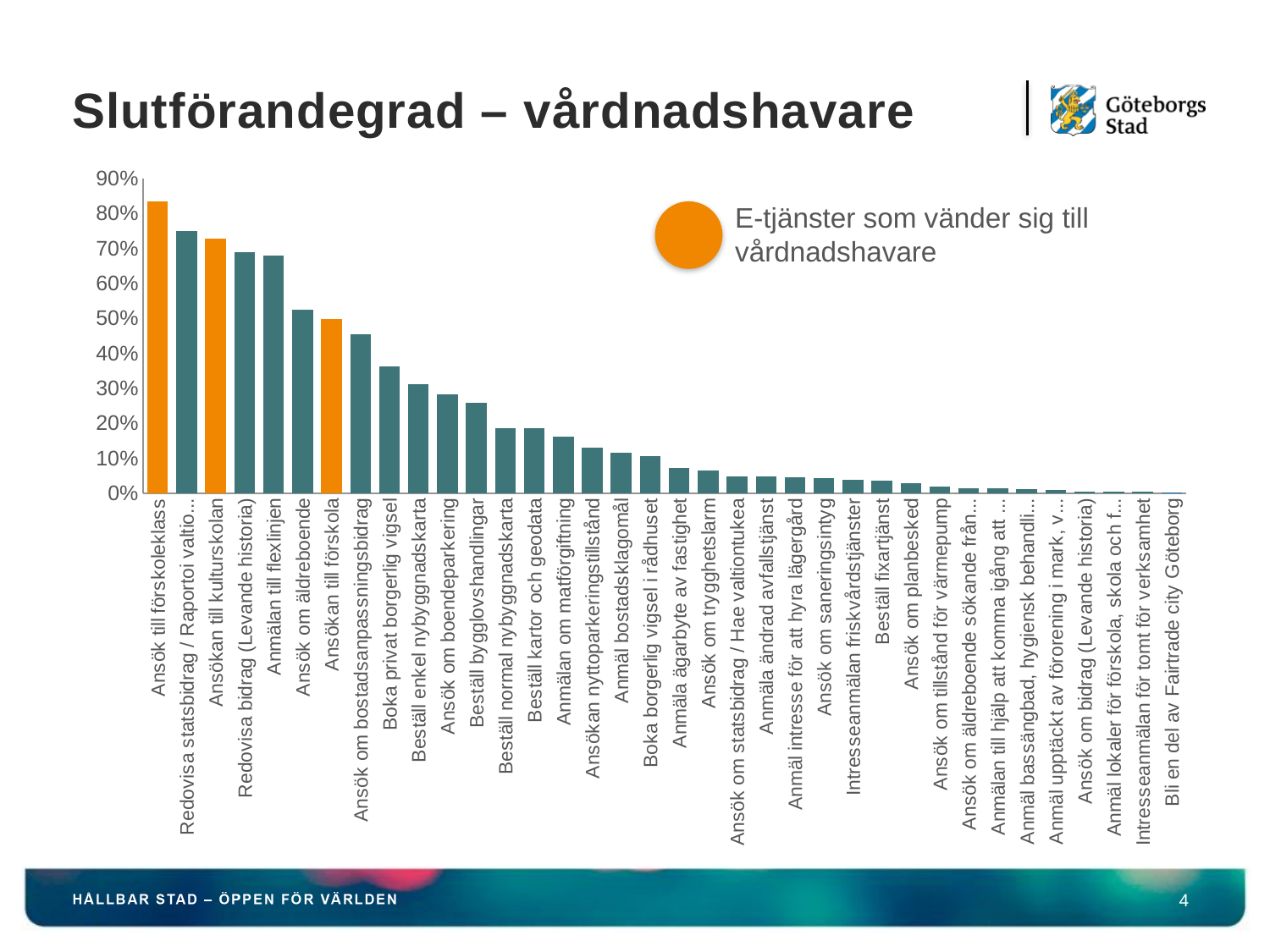
Is the value for Beställ bygglovshandlingar greater or less than 30%? less Is the value for Ansök till förskoleklass greater or less than 80%? greater How many bars are shown in orange? 3 According to the legend, what do the orange bars represent? E-tjänster som vänder sig till vårdnadshavare Do the values rise or fall from left to right along the x axis? fall Is the value for Ansök om bostadsanpassningsbidrag greater or less than 50%? less Which category has the highest value in the chart? Ansök till förskoleklass Which is larger, the value for Ansökan till kulturskolan or the value for Ansök om äldreboende? Ansökan till kulturskolan What kind of chart is shown on the slide? bar chart